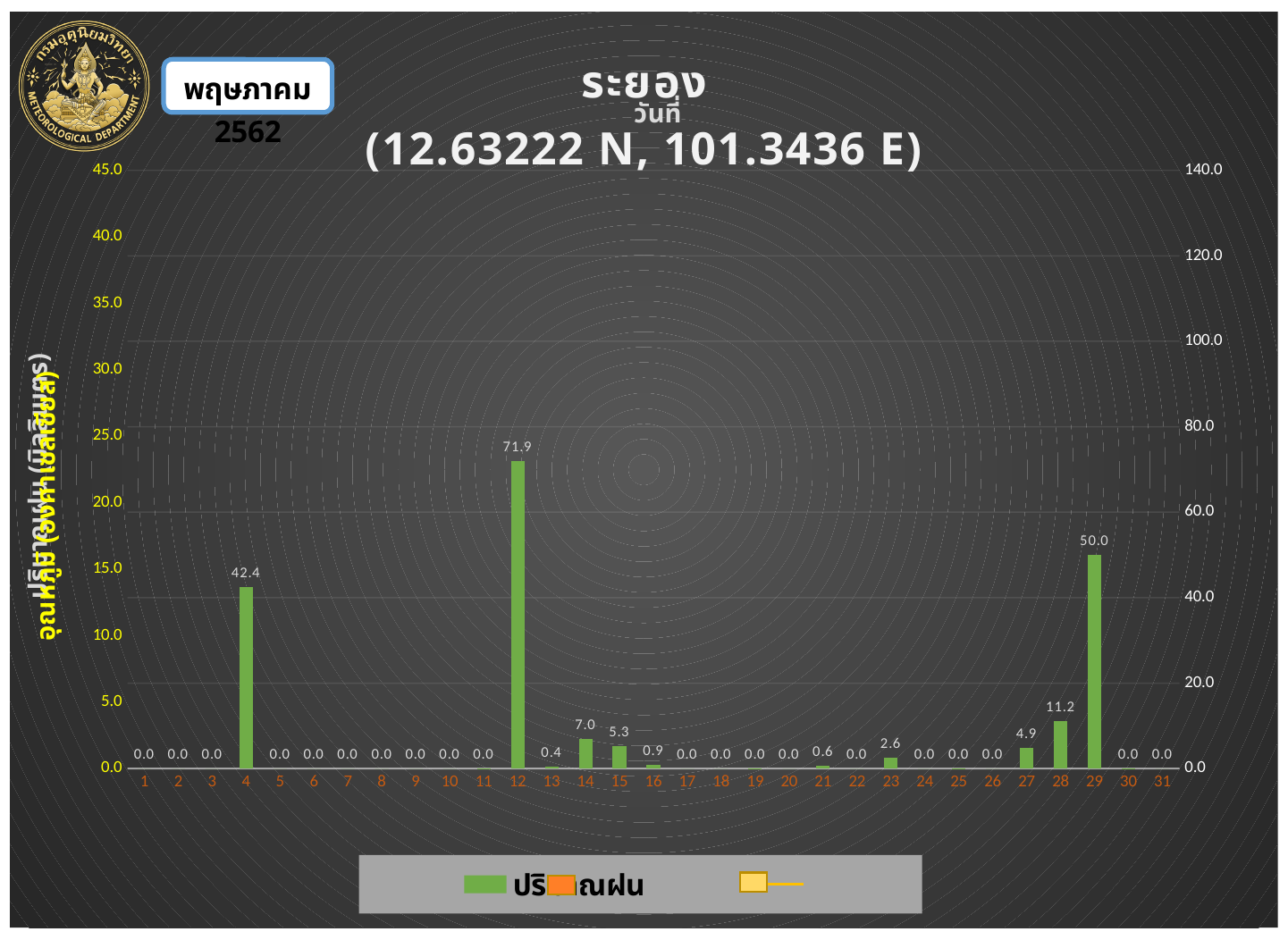
What is the value shown for day 14? 7.0 How many days are shown on the x axis? 31 What is the value shown for day 29? 50.0 What is the value shown for day 12? 71.9 What is the value shown for day 4? 42.4 Which day has the larger value, day 4 or day 29? 29 What kind of chart is shown on the slide? bar chart What is the difference between the values for day 4 and day 28? 31.2 What is the value shown for day 28? 11.2 Which day has the highest value? 12 What station name is shown in the chart title? ระยอง What is the difference between the values for day 12 and day 29? 21.9